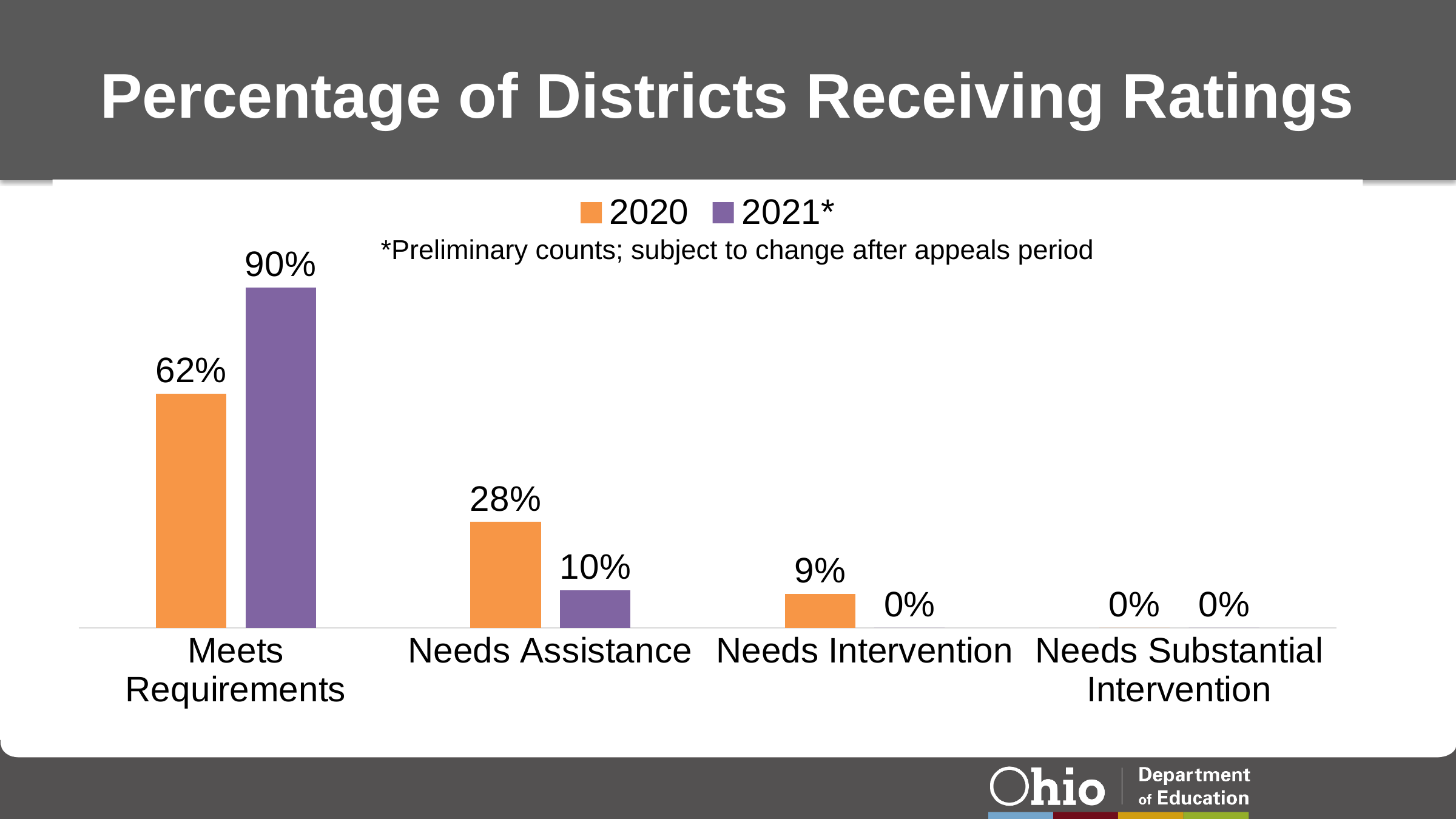
Which rating category has the lowest 2020 value? Needs Substantial Intervention For Needs Assistance, which year has the larger value, 2020 or 2021*? 2020 What is the difference between the 2021* and 2020 values for Meets Requirements? 28% How many rating categories are shown on the x axis? 4 What type of chart is shown on the slide? Bar chart What is the 2021* value for Needs Assistance? 10% What percentage of districts received a Meets Requirements rating in 2020? 62% What is the difference between the 2020 and 2021* values for Needs Assistance? 18% What is the 2020 value for Needs Intervention? 9% How many series does the legend list? 2 Which rating category has the highest 2020 value? Meets Requirements What percentage of districts received a Meets Requirements rating in 2021*? 90%